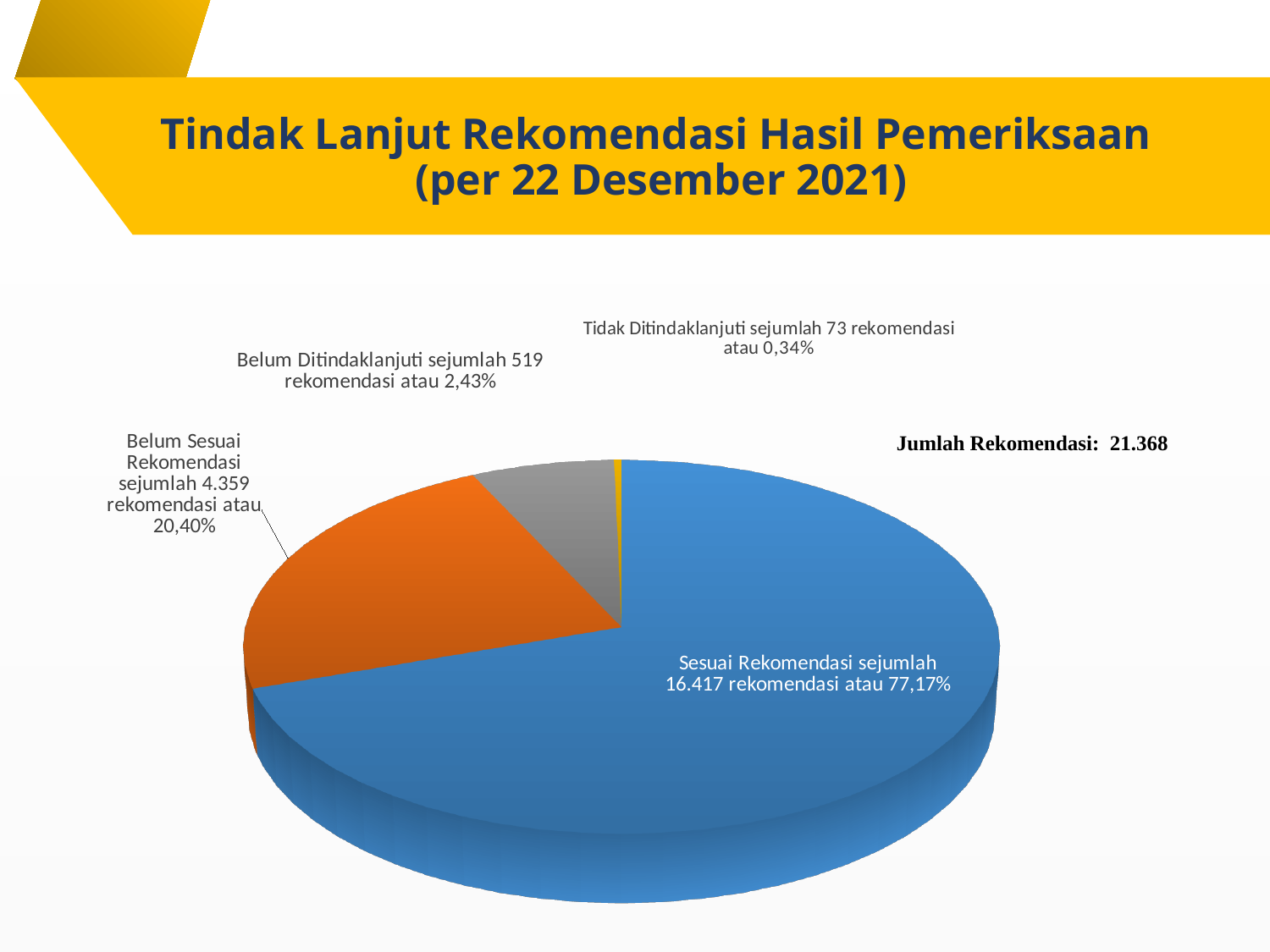
What is the total number of recommendations (Jumlah Rekomendasi) stated on the slide? 21.368 How many recommendations are in the Belum Sesuai Rekomendasi slice? 4.359 What is the difference in number of recommendations between Belum Ditindaklanjuti and Tidak Ditindaklanjuti? 446 How many recommendations are in the Sesuai Rekomendasi slice? 16.417 Which category has the smallest slice of the pie? Tidak Ditindaklanjuti How many recommendations are in the Tidak Ditindaklanjuti slice? 73 How many slices does the pie chart have? 4 What share of the pie does Sesuai Rekomendasi represent? 77,17% What share of the pie does Belum Ditindaklanjuti represent? 2,43% Which is larger, the Belum Sesuai Rekomendasi slice or the Belum Ditindaklanjuti slice? Belum Sesuai Rekomendasi What kind of chart is shown on the slide? pie chart Which category has the largest slice of the pie? Sesuai Rekomendasi